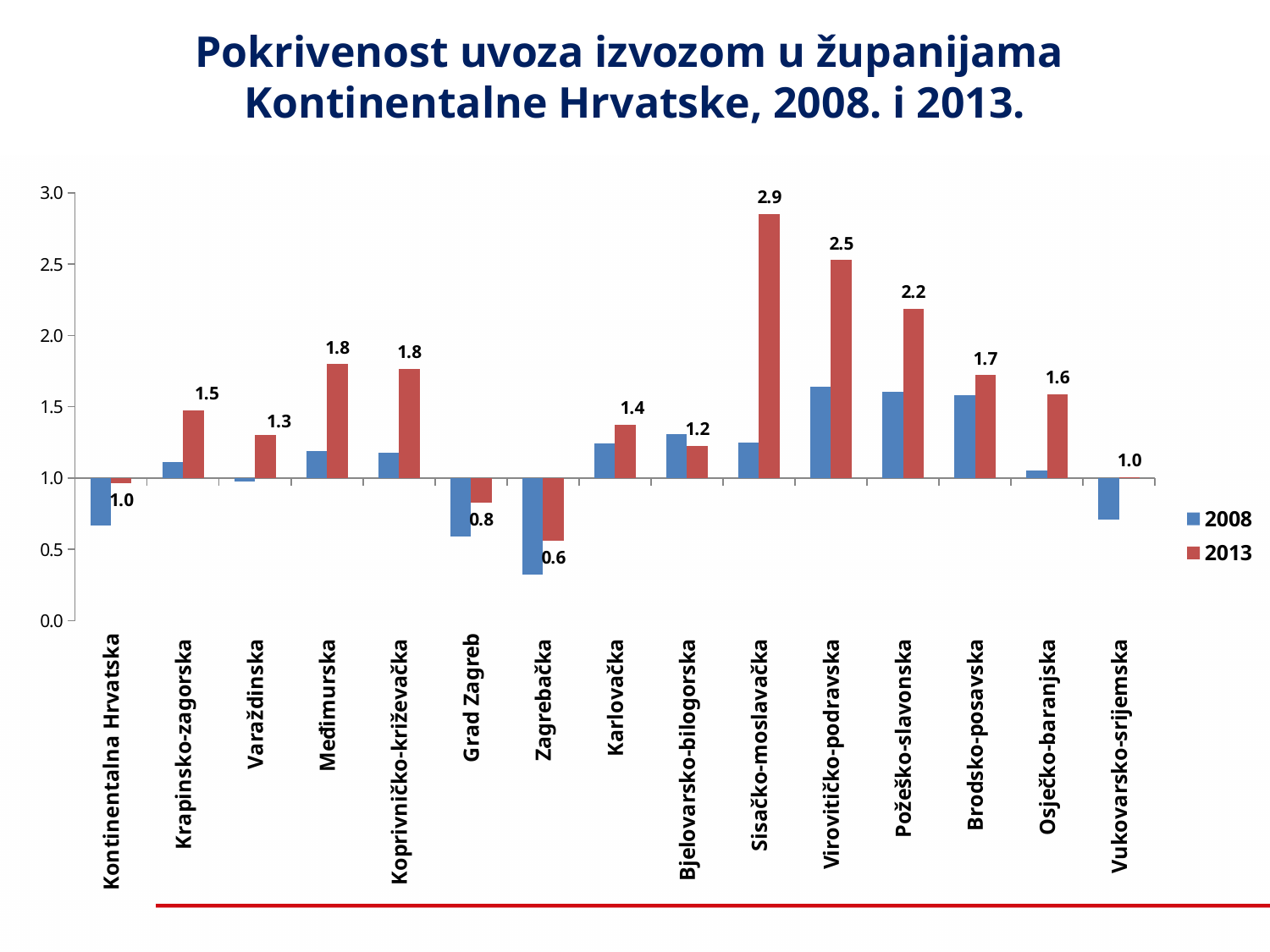
How many counties/categories are shown on the x axis? 15 Is the 2008 value for Zagrebačka greater or less than 0.5? less Which is larger for 2013: Virovitičko-podravska or Brodsko-posavska? Virovitičko-podravska What is the 2013 value for Sisačko-moslavačka? 2.9 What is the 2013 value for Požeško-slavonska? 2.2 How many series does the legend list? 2 What kind of chart is shown on the slide? Bar chart What is the difference between the 2013 values for Sisačko-moslavačka and Zagrebačka? 2.3 Which category has the lowest 2013 value? Zagrebačka Is the 2008 value for Sisačko-moslavačka greater or less than 1.0? greater What is the 2013 value for Grad Zagreb? 0.8 Which county has the highest 2013 value? Sisačko-moslavačka